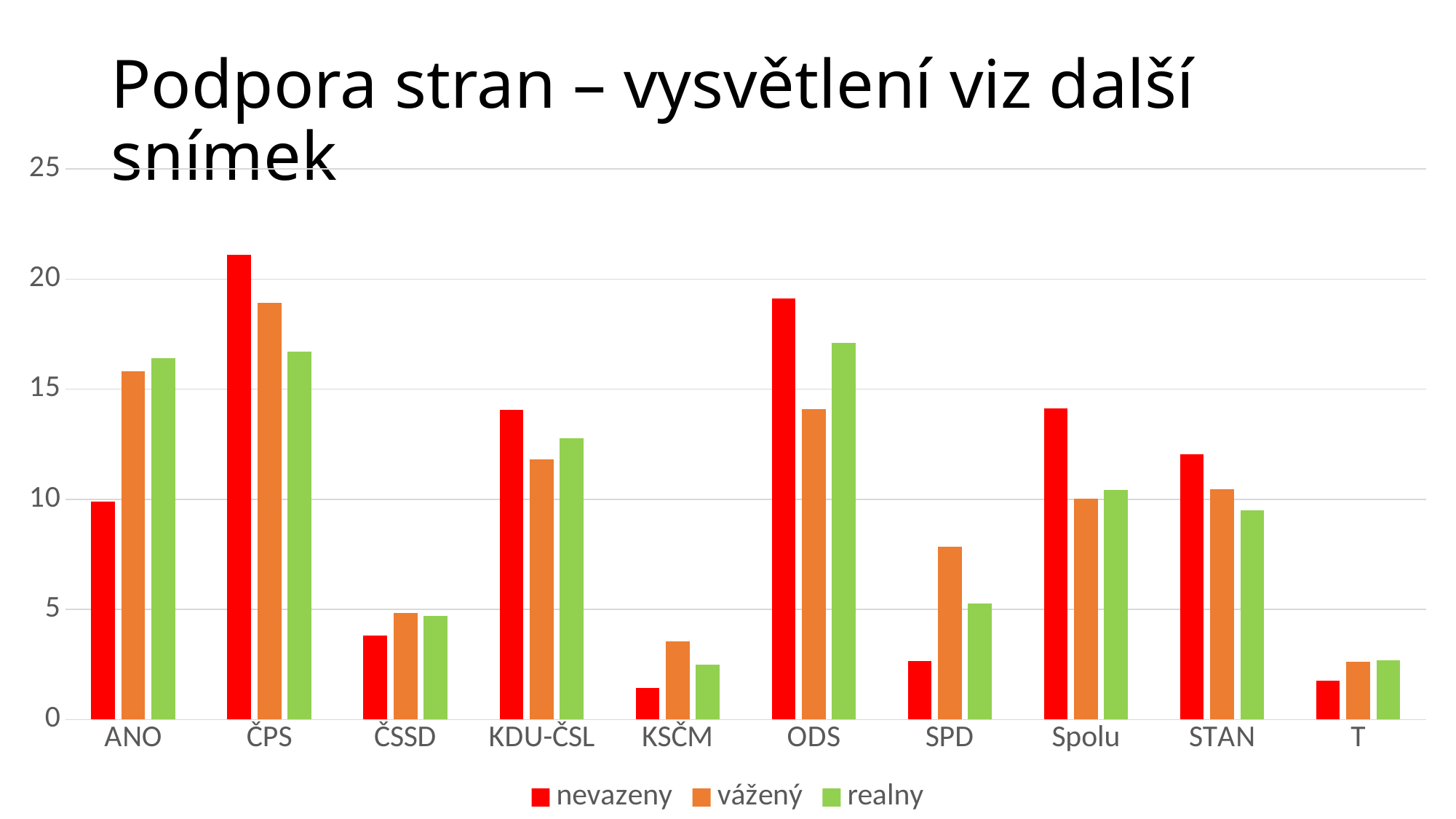
For ANO, which is larger: the nevazeny value or the realny value? realny Is the nevazeny value for ODS greater or less than 20? less How many parties (categories) are shown on the x axis? 10 Which party has the highest nevazeny value? ČPS Which party has the highest vážený value? ČPS How many series does the legend list? 3 For SPD, which is larger: the nevazeny value or the vážený value? vážený What kind of chart is shown on the slide? bar chart Is the nevazeny value for ČPS greater or less than 20? greater Is the nevazeny value for STAN greater or less than 10? greater What colour are the bars for the realny series? green